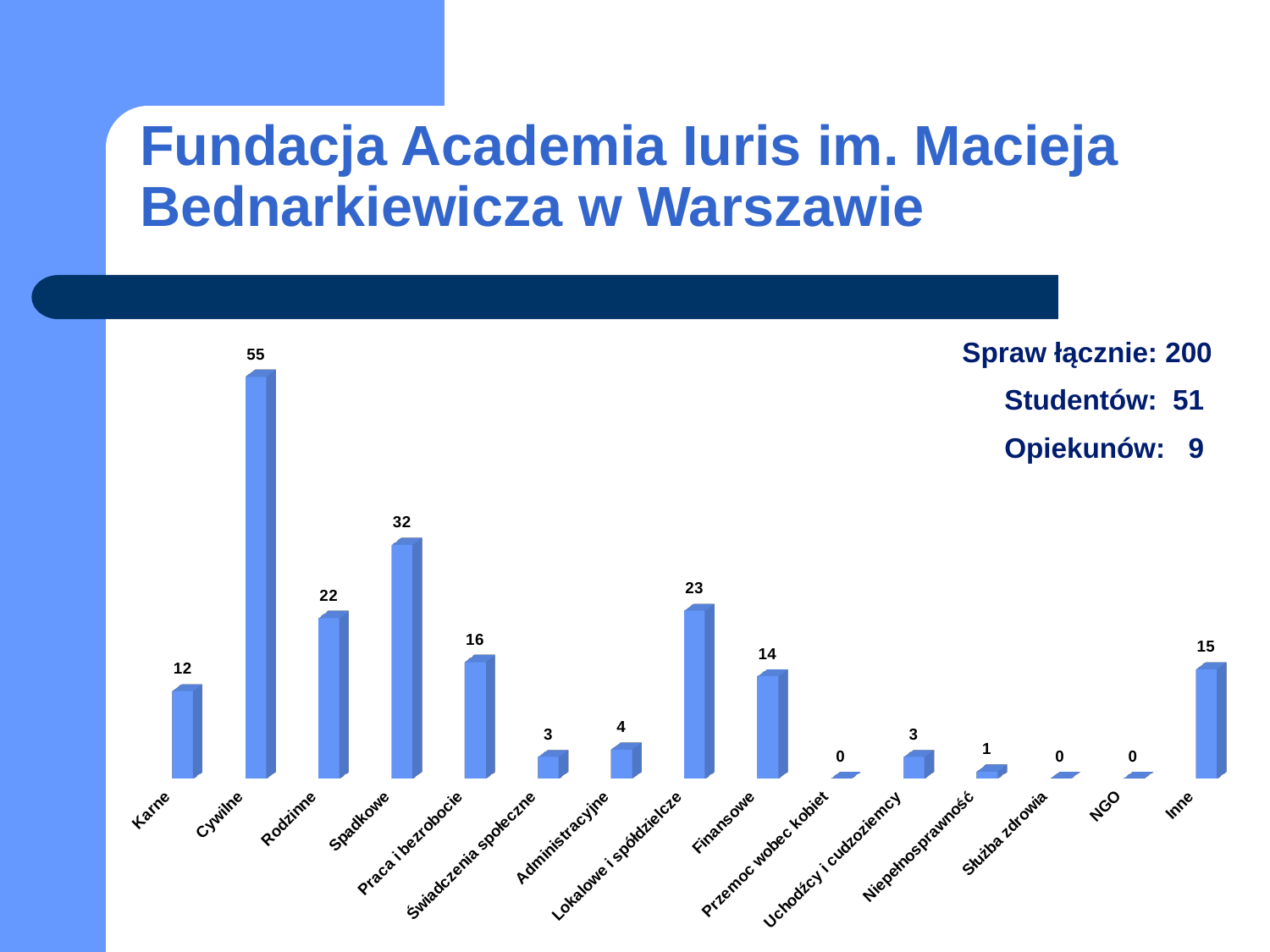
What is the value for Inne? 15 What is the value for Cywilne? 55 How many categories are shown on the x axis? 15 What is the value for Lokalowe i spółdzielcze? 23 How many categories have a value of 0? 3 Which is larger, the value for Administracyjne or the value for Świadczenia społeczne? Administracyjne What is the value for Niepełnosprawność? 1 What is the difference between the values for Cywilne and Spadkowe? 23 What is the difference between the values for Rodzinne and Karne? 10 Which is larger, the value for Finansowe or the value for Praca i bezrobocie? Praca i bezrobocie What kind of chart is shown on the slide? Bar chart Which category has the highest value? Cywilne